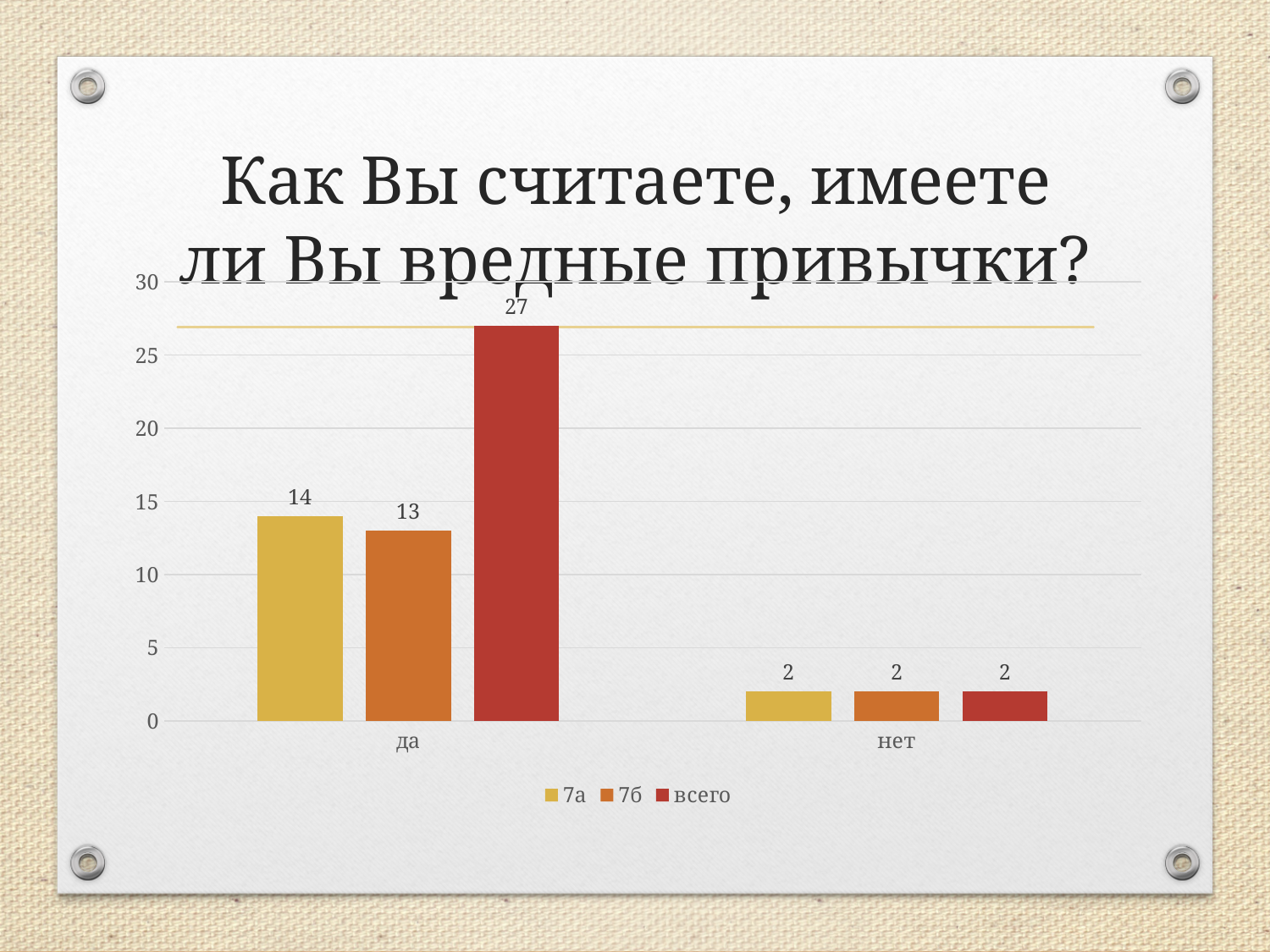
What kind of chart is shown on the slide? bar chart What is the value for всего in the "да" category? 27 How many categories are shown on the x axis? 2 Which category has the highest value for the всего series? да What is the difference between the всего values for "да" and "нет"? 25 What is the value for 7б in the "да" category? 13 Is the value for всего in the "да" category greater or less than 25? greater Which category has the lowest value for the 7а series? нет Which is larger in the "да" category: 7а or 7б? 7а What is the value for 7а in the "да" category? 14 What is the value for всего in the "нет" category? 2 How many series does the legend list? 3